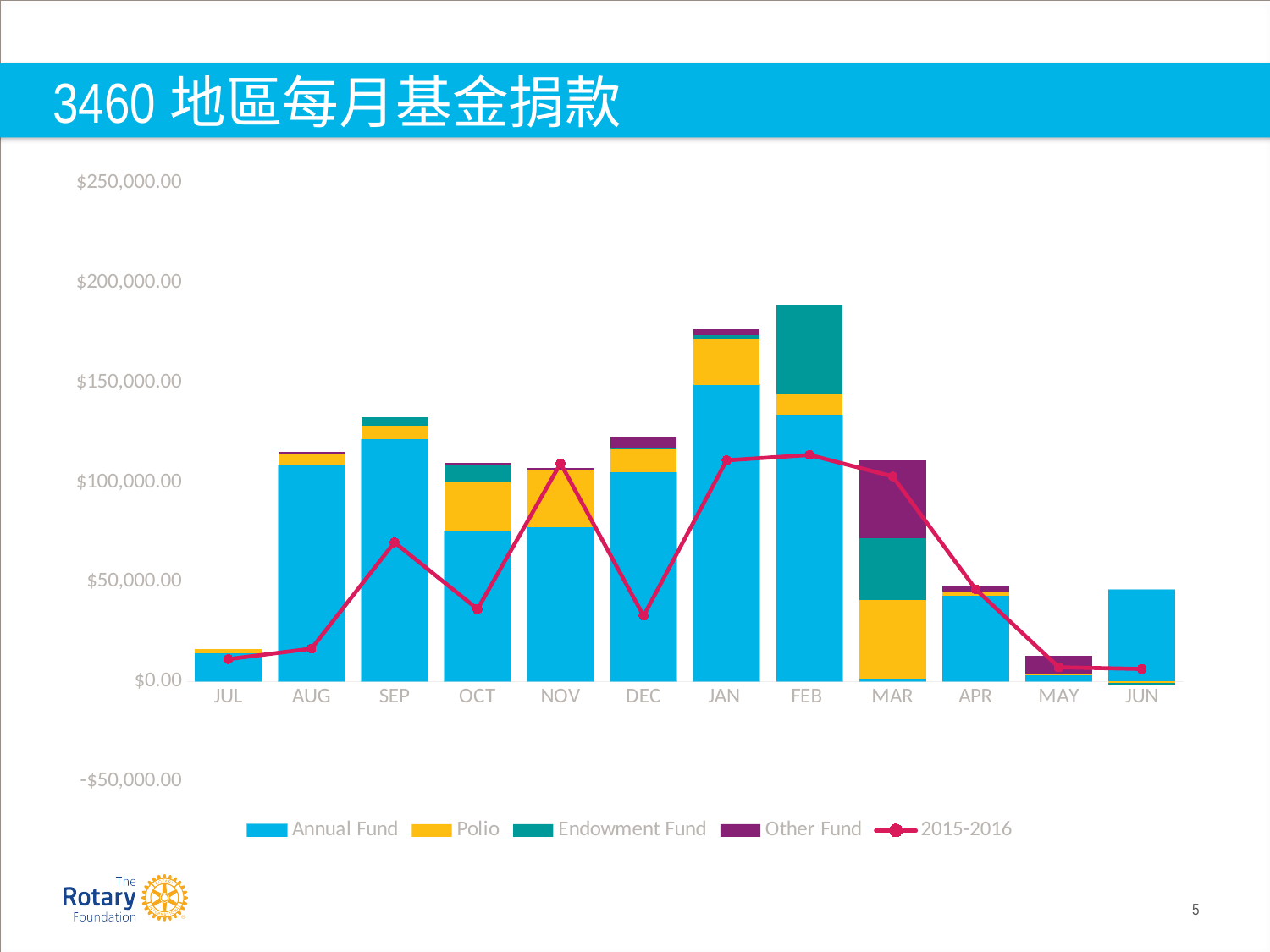
Which month has the largest Endowment Fund segment? FEB How many series does the legend list? 5 Is the total stacked bar for JUN greater or less than $50,000.00? less Does the 2015-2016 line rise or fall from FEB to MAY? Falls Which month has the largest Other Fund segment? MAR Is the total stacked bar for FEB greater or less than $150,000.00? greater What kind of chart is shown on the slide? Stacked bar chart with a line Is the 2015-2016 line value for DEC greater or less than $50,000.00? less Which series is shown in yellow in the legend? Polio Which month has the tallest stacked bar? FEB How many months are shown along the x axis? 12